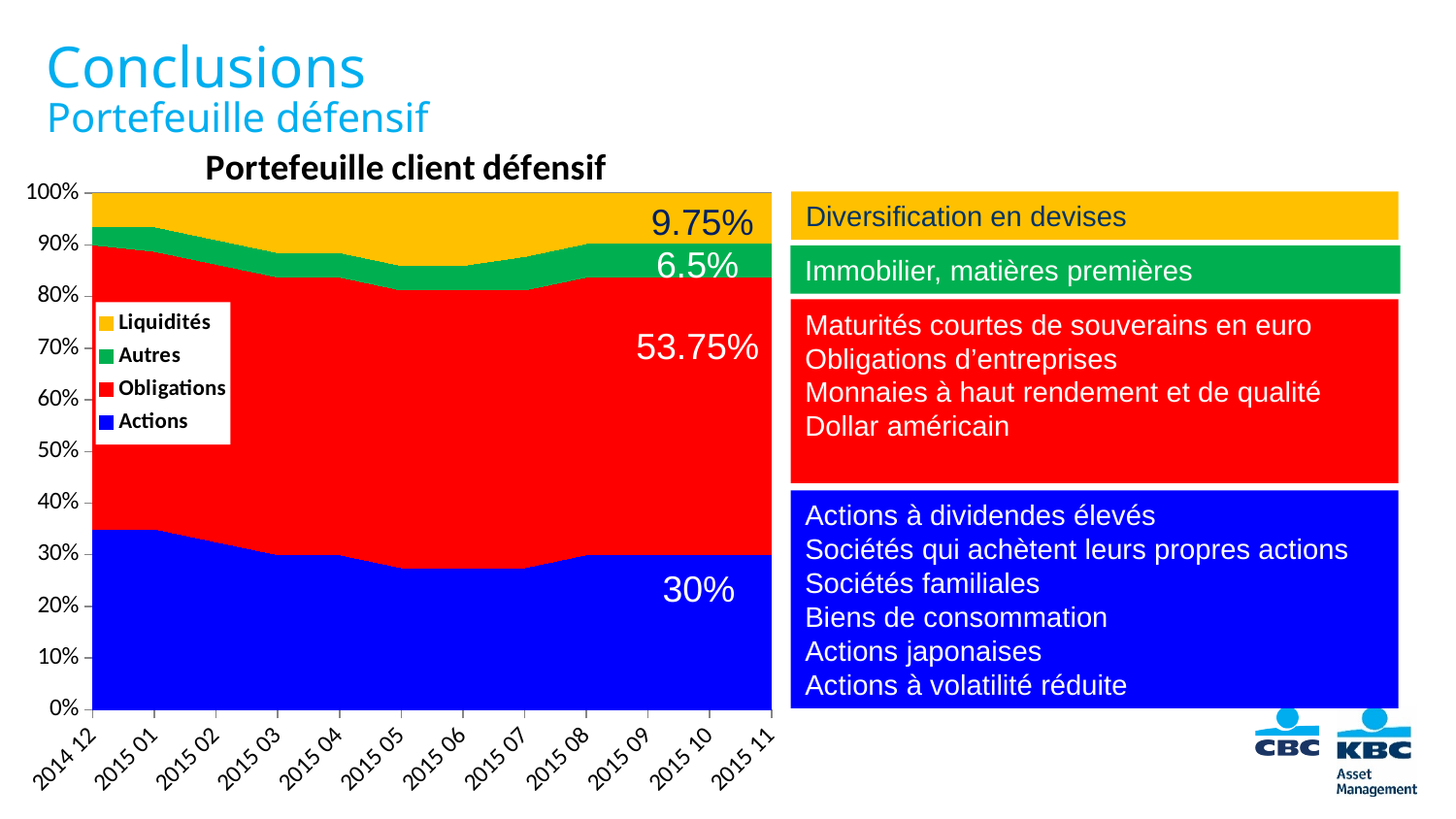
Which series are listed in the chart's legend? Liquidités, Autres, Obligations, Actions How many time points are shown along the x axis of the chart? 12 What value is labelled for Liquidités on the chart? 9.75% How many series does the chart's legend list? 4 What value is labelled for Autres on the chart? 6.5% What value is labelled for Obligations on the chart? 53.75% What value is labelled for Actions on the chart? 30% Which series has the largest labelled share on the chart? Obligations What kind of chart is shown on the slide? Stacked area chart Which series has the smallest labelled share on the chart? Autres What is the title of the chart? Portefeuille client défensif What is the difference between the labelled values for Obligations and Actions? 23.75%